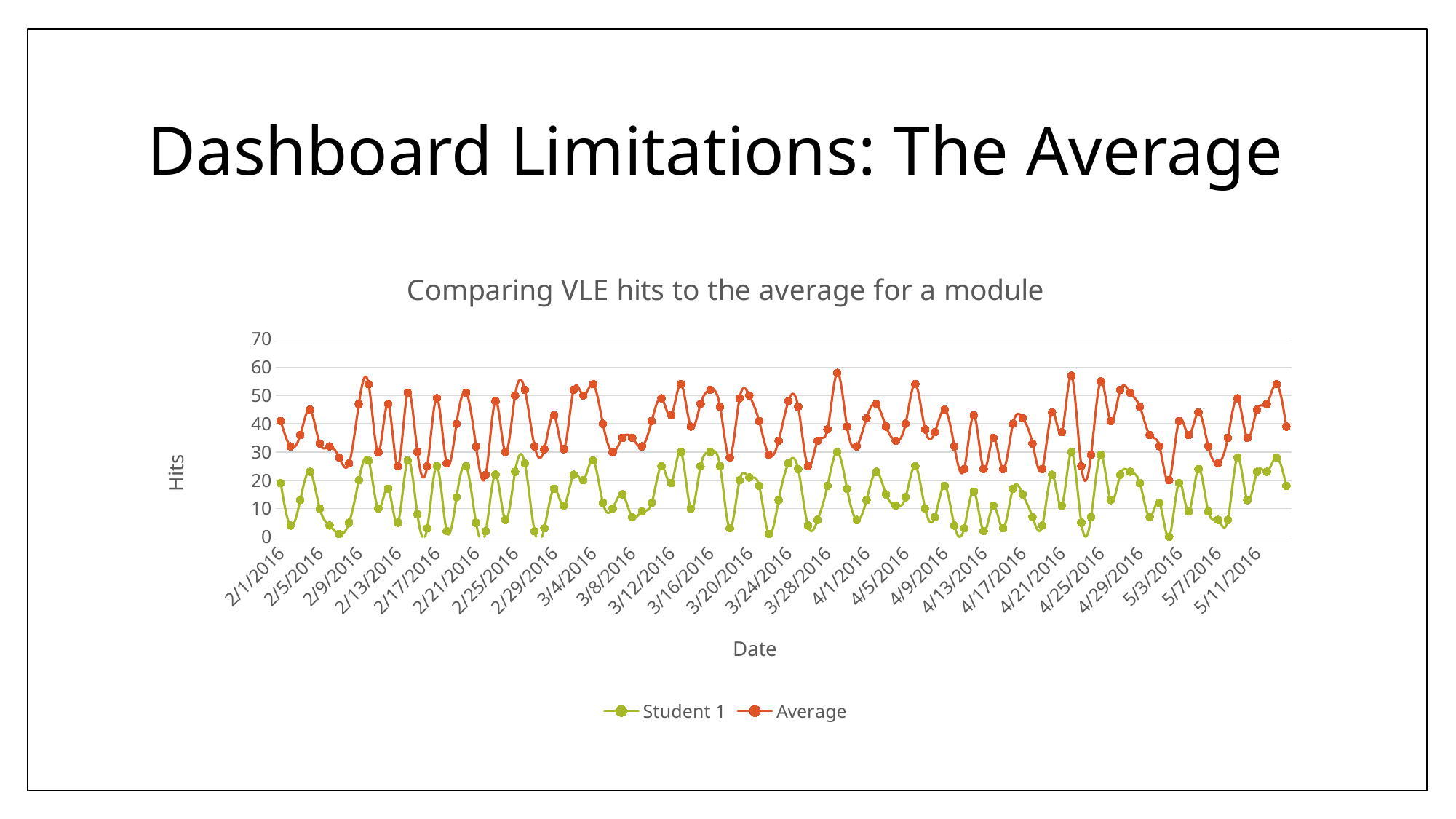
Is the highest value reached by the Student 1 series greater or less than 40? less Which series stays higher across the whole date range, Student 1 or Average? Average What is the label of the vertical axis? Hits How many series does the chart legend list? 2 What is the title of the chart? Comparing VLE hits to the average for a module Which series has the higher value on 2/1/2016, Student 1 or Average? Average Is the highest value reached by the Average series greater or less than 50? greater Is the value for Average on 2/1/2016 greater or less than 30? greater Which series is plotted in green? Student 1 What kind of chart is shown on the slide? line chart